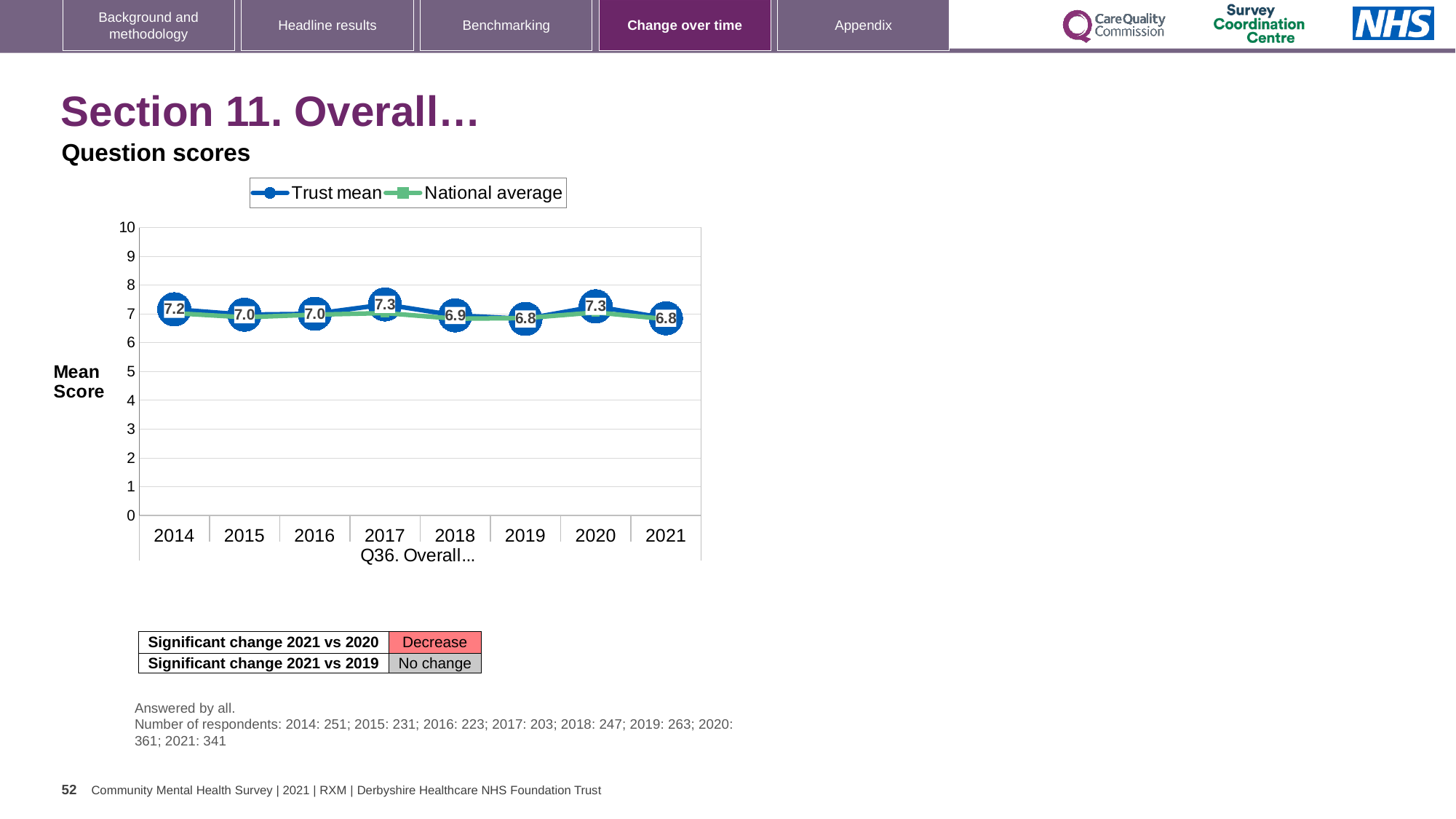
Does the Trust mean score rise or fall from 2020 to 2021? fall How many series does the chart legend list? 2 What is the Trust mean score for 2017? 7.3 What kind of chart is shown on the slide? line chart Which year has the higher Trust mean score, 2017 or 2018? 2017 What is the Trust mean score for 2021? 6.8 Is the National average value for 2014 greater or less than 8? less What is the Trust mean score for 2014? 7.2 What are the two series named in the chart legend? Trust mean and National average What is the Trust mean score for 2018? 6.9 How many years are shown on the x axis of the chart? 8 What is the difference between the Trust mean scores for 2020 and 2021? 0.5